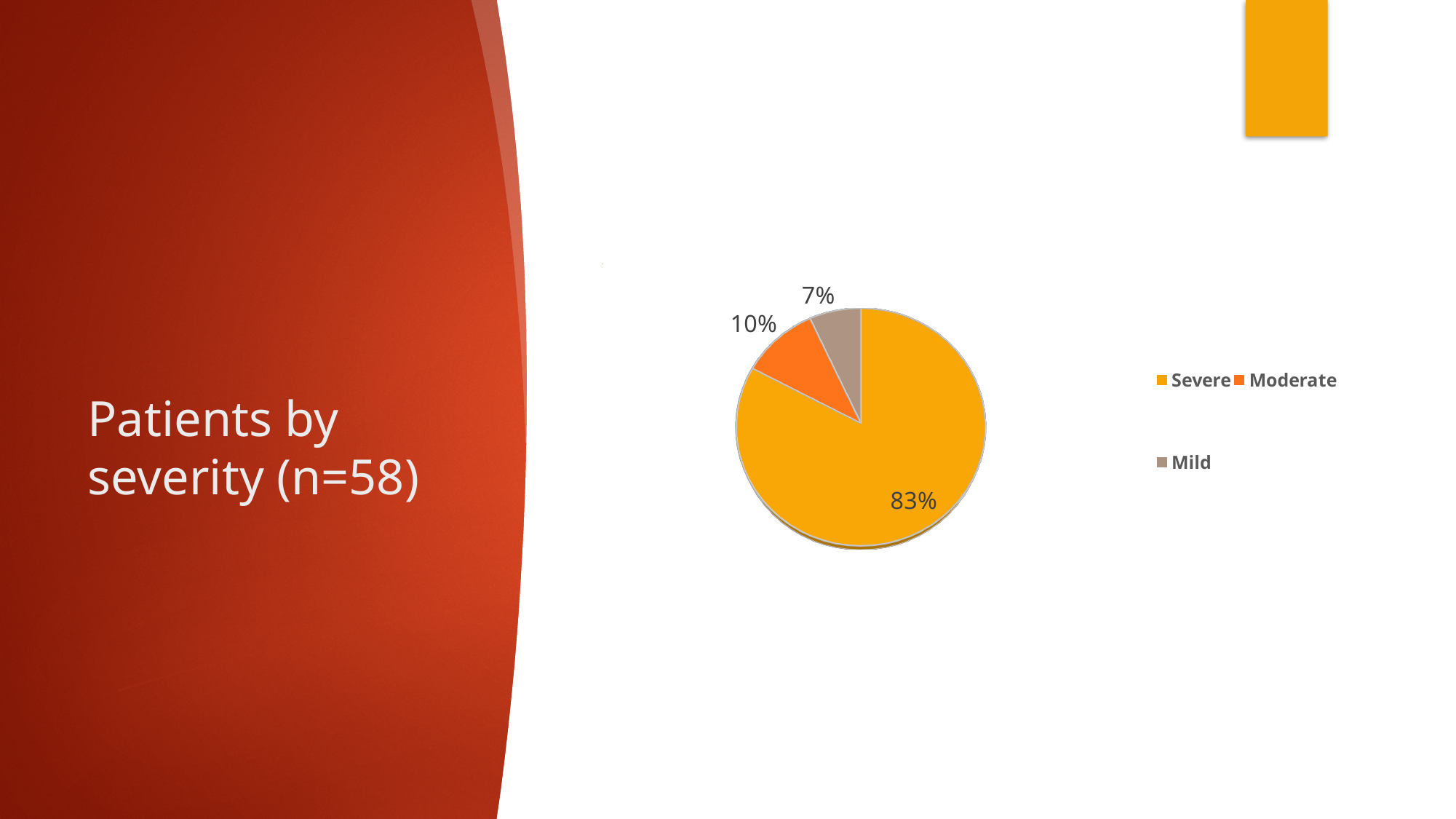
Which severity category has the largest share of patients? Severe What percentage of patients are in the Severe category? 83% What type of chart is shown on the slide? pie chart How many categories does the pie chart show? 3 Which is larger, the Moderate share or the Mild share? Moderate Which colour represents the Mild category in the pie chart? grey/tan What percentage of patients are in the Mild category? 7% How many percentage points larger is the Moderate share than the Mild share? 3 Which severity category has the smallest share of patients? Mild How many percentage points larger is the Severe share than the Moderate share? 73 What percentage of patients are in the Moderate category? 10% What is the title of the slide containing the pie chart? Patients by severity (n=58)